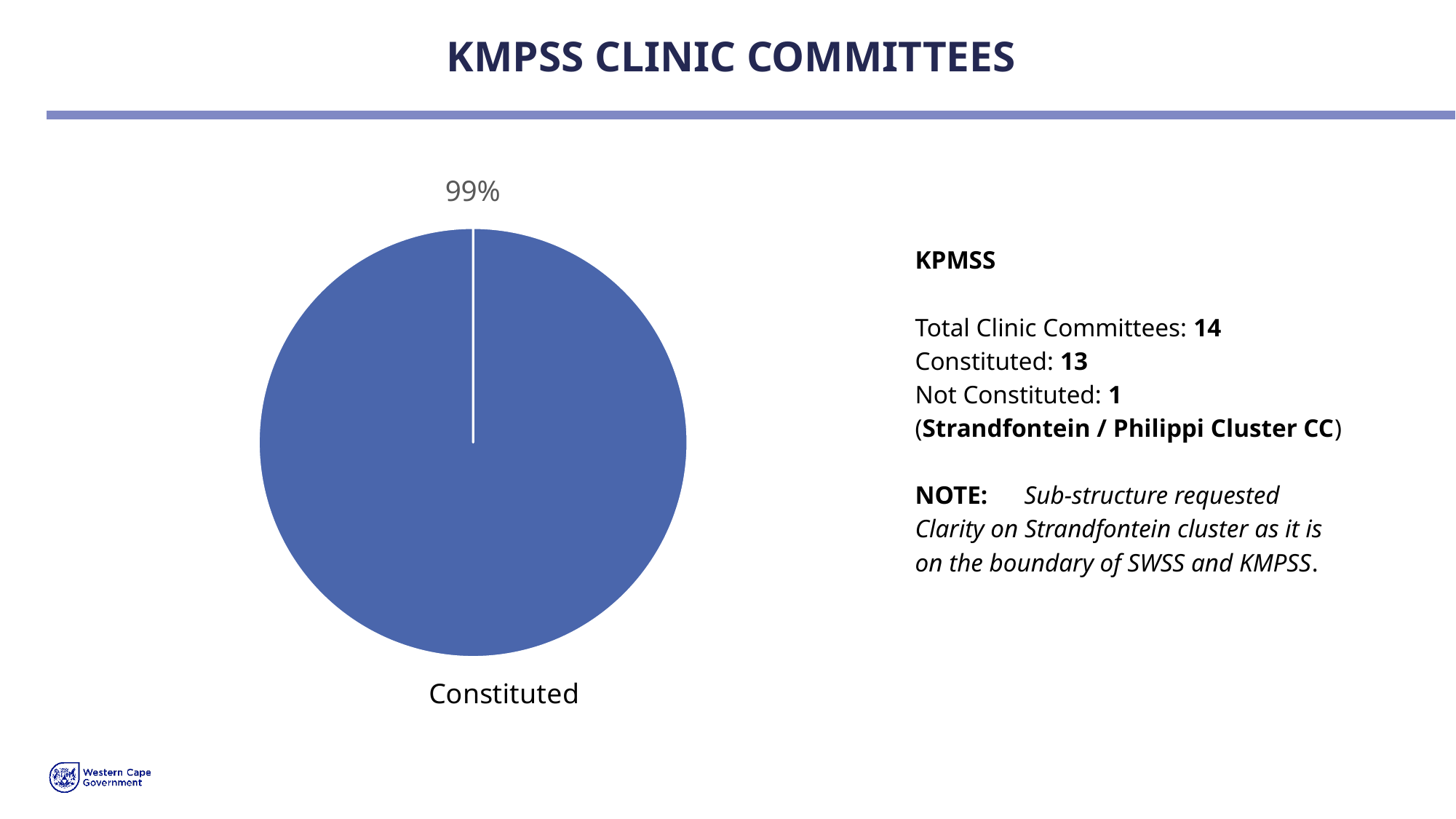
Is the share of the Constituted slice greater or less than 50%? greater What kind of chart is shown on the slide? pie chart What is the title of the slide containing the pie chart? KMPSS CLINIC COMMITTEES What percentage does the Constituted slice of the pie chart represent? 99% What share of the pie does the Constituted slice take up? 99% Which category has the largest slice in the pie chart? Constituted